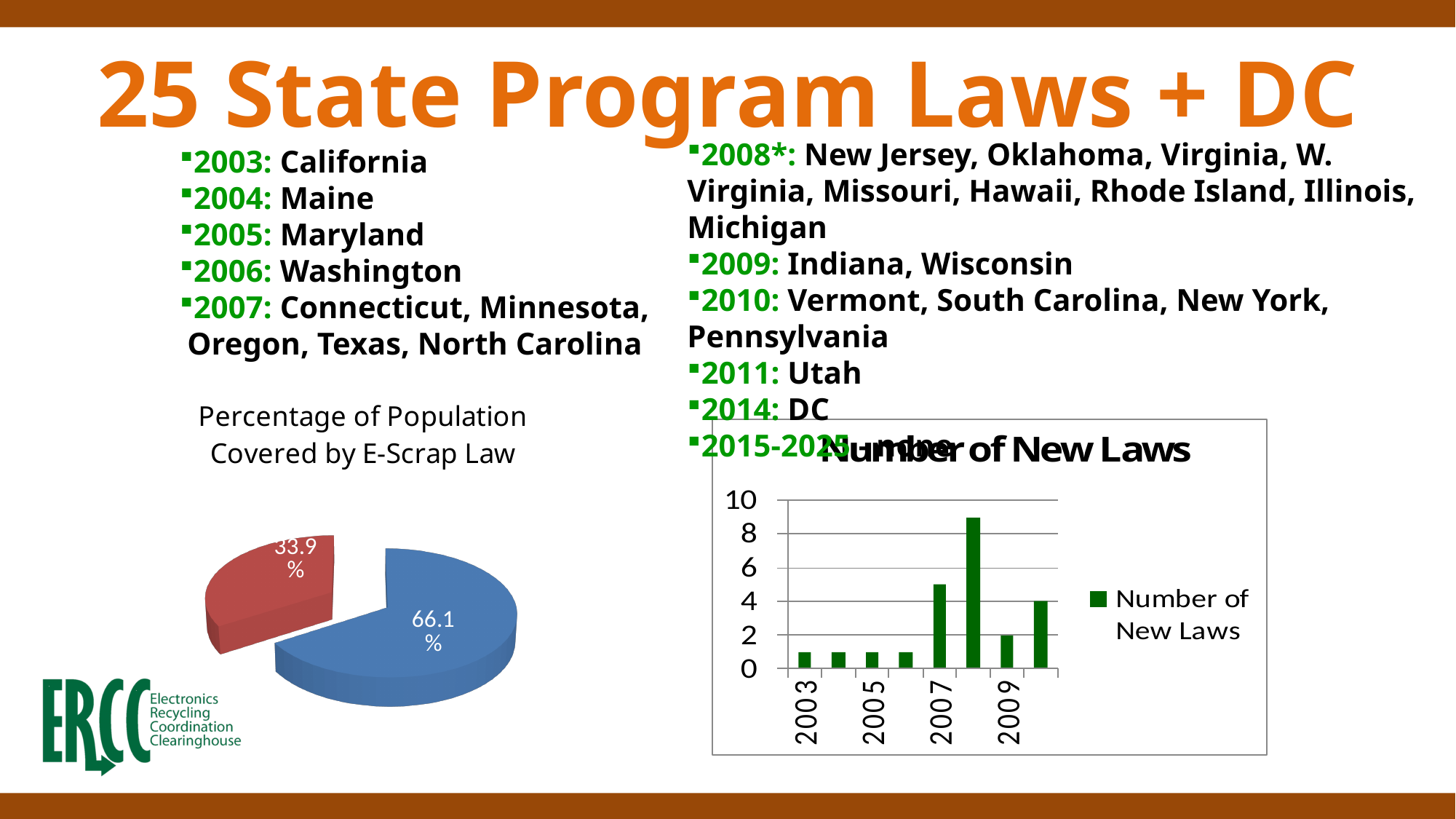
On the 'Number of New Laws' chart, is the value for 2008 greater or less than 8? greater On the 'Percentage of Population Covered by E-Scrap Law' pie chart, what share does the blue slice represent? 66.1% On the 'Number of New Laws' chart, which is larger, the value for 2007 or the value for 2009? 2007 On the 'Number of New Laws' chart, is the value for 2003 greater or less than 2? less On the 'Number of New Laws' chart, what is the value for 2010? 4 How many series does the legend of the 'Number of New Laws' chart list? 1 How many bars are plotted on the 'Number of New Laws' chart? 8 On the 'Percentage of Population Covered by E-Scrap Law' pie chart, what is the difference between the two slices? 32.2% On the 'Number of New Laws' chart, is the value for 2007 greater or less than 4? greater On the 'Number of New Laws' chart, which year has the highest bar? 2008 What kind of chart is the 'Number of New Laws' chart? bar chart On the 'Number of New Laws' chart, what is the value for 2009? 2